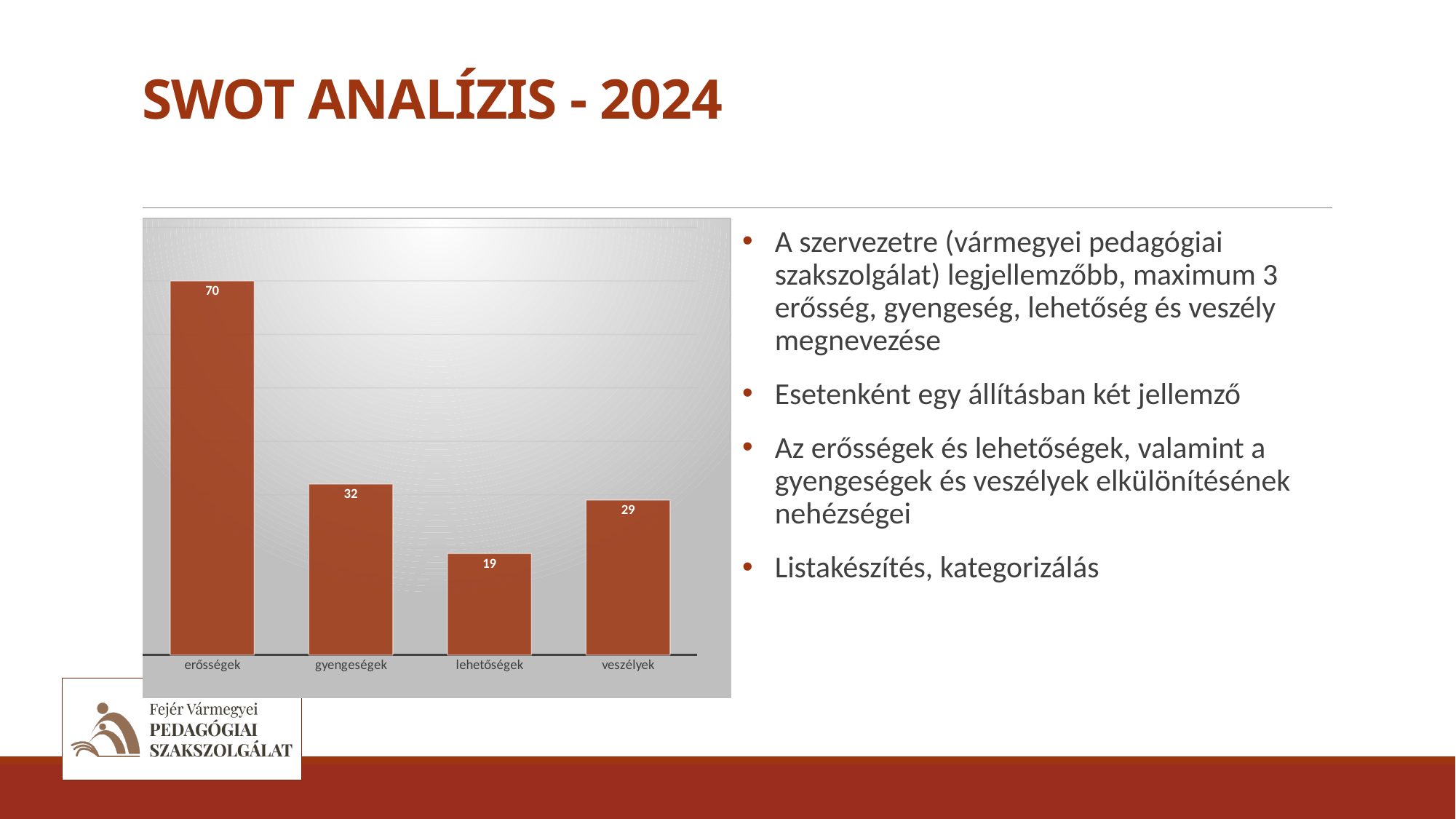
How many categories are shown in the chart? 4 What colour are the bars in the chart? brown What is the value for gyengeségek? 32 What is the difference between the values for veszélyek and lehetőségek? 10 What is the value for erősségek? 70 What is the value for veszélyek? 29 What is the difference between the values for erősségek and gyengeségek? 38 What kind of chart is shown on the slide? bar chart What is the value for lehetőségek? 19 Which is larger, the value for gyengeségek or the value for veszélyek? gyengeségek Which category has the highest value? erősségek Which category has the lowest value? lehetőségek